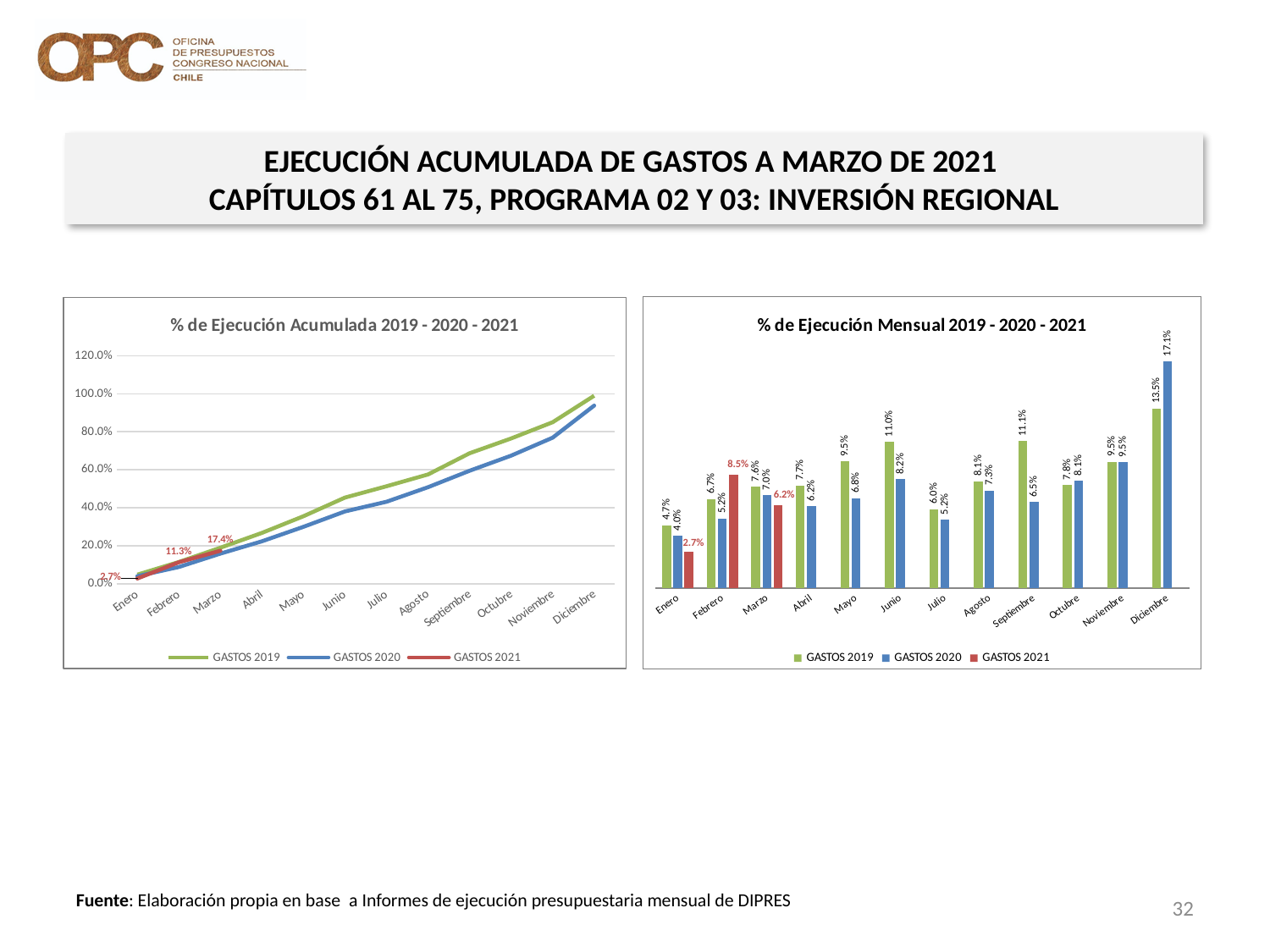
In the right chart '% de Ejecución Mensual', what is the difference between GASTOS 2020 and GASTOS 2019 in Diciembre? 3.6% In the left chart '% de Ejecución Acumulada', what is the value of GASTOS 2021 in Febrero? 11.3% How many series does the legend of the left chart '% de Ejecución Acumulada' list? 3 What kind of chart is the left chart titled '% de Ejecución Acumulada 2019 - 2020 - 2021'? Line chart In the left chart '% de Ejecución Acumulada', is the value of GASTOS 2019 in Diciembre greater or less than 80.0%? greater In the right chart '% de Ejecución Mensual', which is larger in Febrero: GASTOS 2019 or GASTOS 2021? GASTOS 2021 What kind of chart is the right chart titled '% de Ejecución Mensual 2019 - 2020 - 2021'? Bar chart In the right chart '% de Ejecución Mensual', which month has the highest value for GASTOS 2019? Diciembre In the right chart '% de Ejecución Mensual', which month has the lowest value for GASTOS 2020? Enero In the right chart '% de Ejecución Mensual', what is the value of GASTOS 2021 in Marzo? 6.2% In the right chart '% de Ejecución Mensual', what is the value of GASTOS 2020 in Diciembre? 17.1% In the left chart '% de Ejecución Acumulada', what is the value of GASTOS 2021 in Marzo? 17.4%